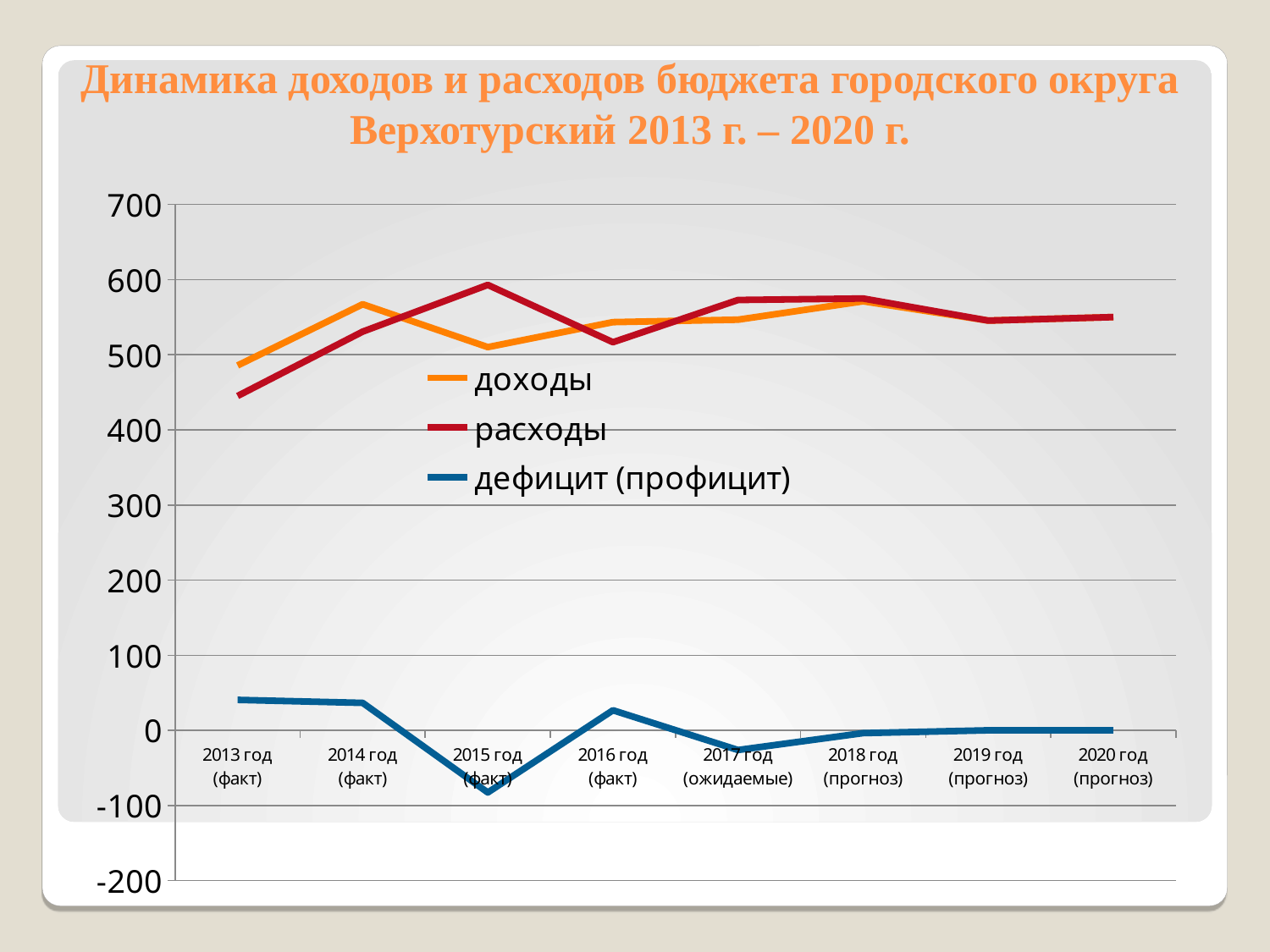
How many series does the legend list? 3 What kind of chart is shown on the slide? line chart Is the value of дефицит (профицит) for 2015 год (факт) greater or less than 0? less Is the value of расходы for 2013 год (факт) greater or less than 500? less Is the value of расходы for 2015 год (факт) greater or less than 500? greater Which colour is used for the расходы series? red Does the доходы series rise or fall from 2013 год (факт) to 2014 год (факт)? rise In 2015 год (факт), which is larger: доходы or расходы? расходы In which year does the расходы series reach its highest value? 2015 год (факт) In 2014 год (факт), which is larger: доходы or расходы? доходы In which year is the дефицит (профицит) series at its lowest value? 2015 год (факт) How many years are shown on the x axis? 8